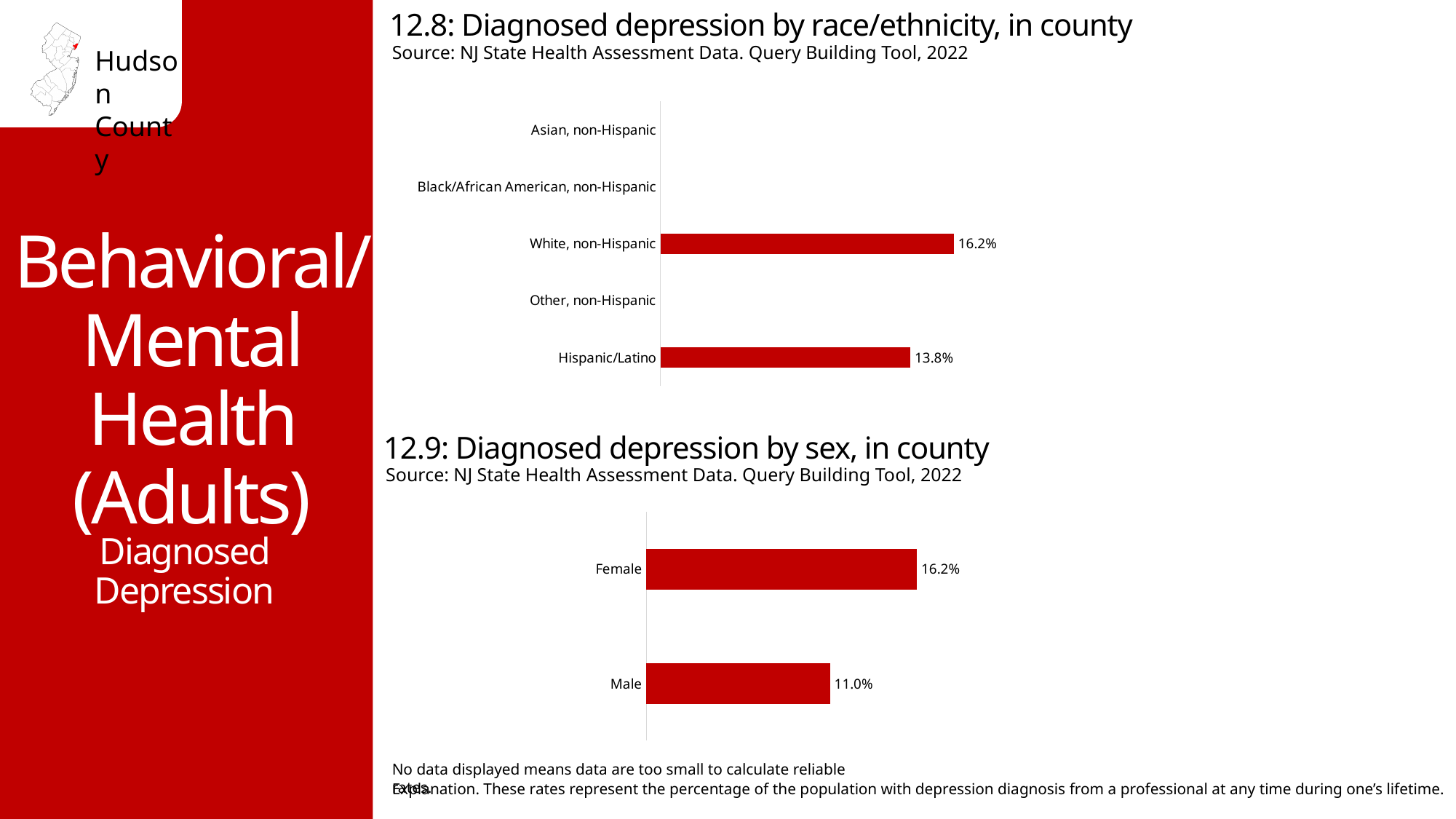
In the chart '12.8: Diagnosed depression by race/ethnicity, in county', what is the value for White, non-Hispanic? 16.2% In the chart '12.8: Diagnosed depression by race/ethnicity, in county', how many categories are listed on the axis? 5 In the chart '12.8: Diagnosed depression by race/ethnicity, in county', what is the value for Hispanic/Latino? 13.8% What is the source cited for the chart '12.9: Diagnosed depression by sex, in county'? NJ State Health Assessment Data. Query Building Tool, 2022 What kind of chart is '12.8: Diagnosed depression by race/ethnicity, in county'? Bar chart In the chart '12.9: Diagnosed depression by sex, in county', which category has the lowest value? Male In the chart '12.8: Diagnosed depression by race/ethnicity, in county', which category has the highest value shown? White, non-Hispanic In the chart '12.9: Diagnosed depression by sex, in county', what is the difference between the Female and Male values? 5.2% In the chart '12.8: Diagnosed depression by race/ethnicity, in county', what is the difference between the White, non-Hispanic and Hispanic/Latino values? 2.4% In the chart '12.9: Diagnosed depression by sex, in county', what is the value for Female? 16.2% In the chart '12.9: Diagnosed depression by sex, in county', what is the value for Male? 11.0% In the chart '12.8: Diagnosed depression by race/ethnicity, in county', how many categories have a bar displayed? 2